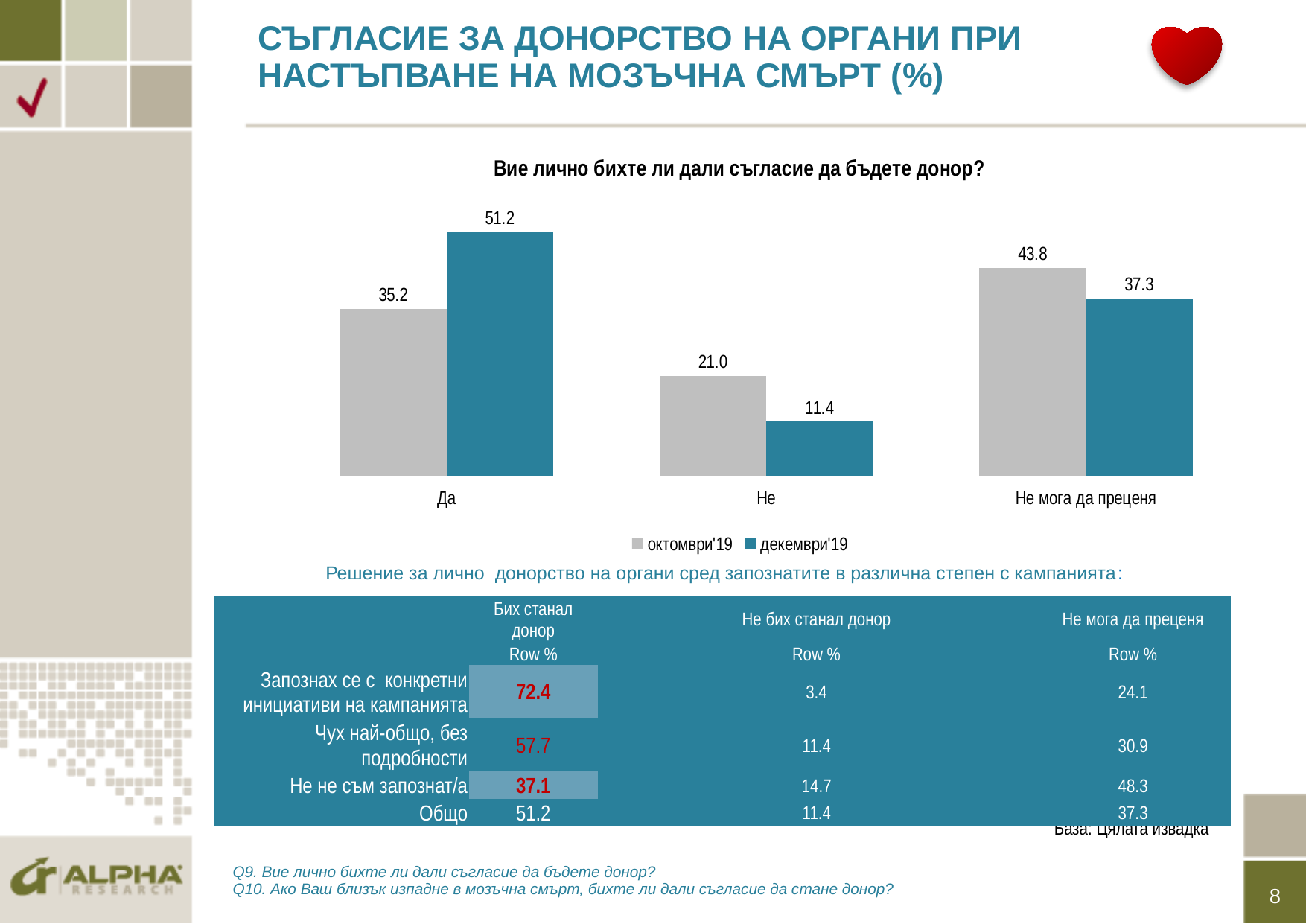
How many categories are shown on the x axis of the chart? 3 What is the value for "Не мога да преценя" in the декември'19 series? 37.3 What is the value for "Да" in the декември'19 series? 51.2 What is the difference between the декември'19 and октомври'19 values for "Да"? 16.0 Which category has the highest value in the октомври'19 series? Не мога да преценя Which category has the lowest value in the декември'19 series? Не What kind of chart is shown on the slide? bar chart Which is larger for "Не мога да преценя": the октомври'19 value or the декември'19 value? октомври'19 What is the difference between the октомври'19 and декември'19 values for "Не"? 9.6 How many series does the chart legend list? 2 What is the title of the chart? Вие лично бихте ли дали съгласие да бъдете донор? What is the value for "Не" in the октомври'19 series? 21.0